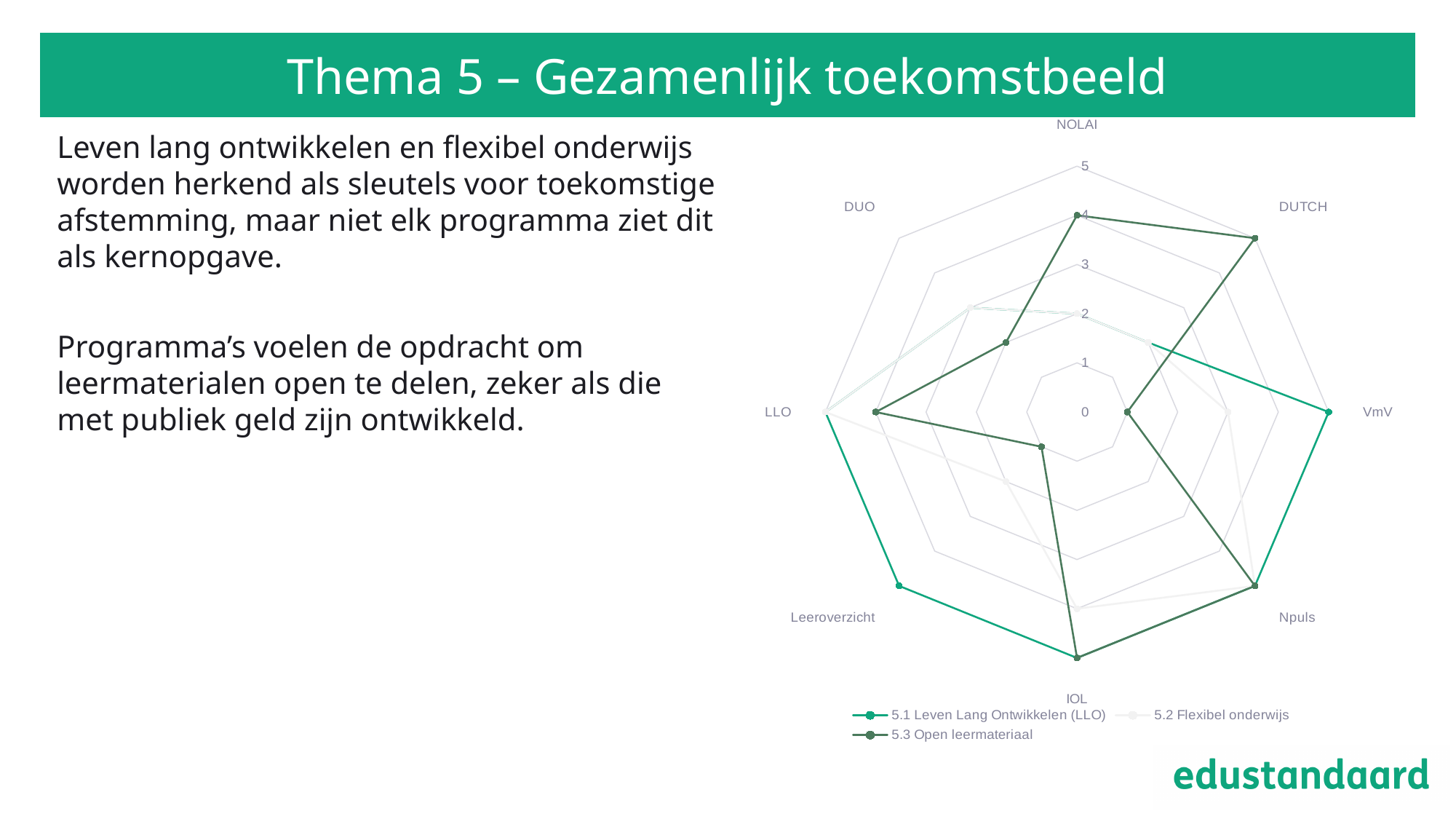
How many categories (axes) does the radar chart have? 8 What kind of chart is shown on the slide? Radar chart What is the highest value shown on the radar chart's axis scale? 5 What is the value of 5.3 Open leermateriaal for DUTCH? 5 Which series is drawn in the lightest colour in the radar chart? 5.2 Flexibel onderwijs Is the value of 5.3 Open leermateriaal for VmV greater or less than 2? less For which category does 5.3 Open leermateriaal have its lowest value? VmV and Leeroverzicht What is the value of 5.3 Open leermateriaal for NOLAI? 4 Is the value of 5.1 Leven Lang Ontwikkelen (LLO) for Leeroverzicht greater or less than 3? greater What is the value of 5.1 Leven Lang Ontwikkelen (LLO) for VmV? 5 For VmV, which series has the larger value: 5.1 Leven Lang Ontwikkelen (LLO) or 5.3 Open leermateriaal? 5.1 Leven Lang Ontwikkelen (LLO) How many series does the legend of the radar chart list? 3